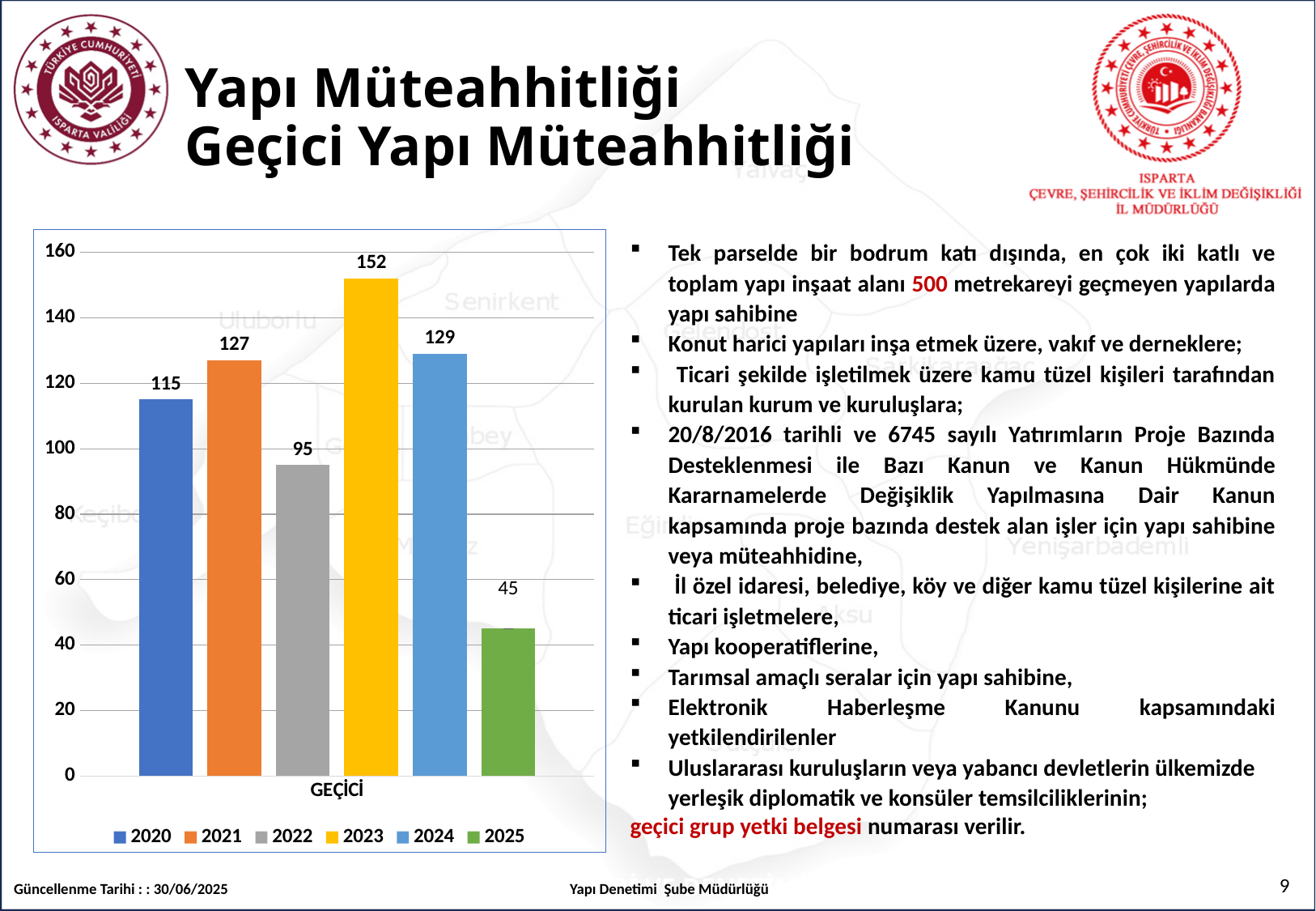
Which is larger, the value for 2021 or the value for 2024? 2024 Which year has the highest value in the chart? 2023 Is the value for 2022 greater or less than 100? less What colour is the bar for 2023 in the chart? yellow What is the value for 2025 in the chart? 45 What kind of chart is shown on the slide? bar chart What is the category label shown on the x axis of the chart? GEÇİCİ What is the difference between the values for 2023 and 2022? 57 What is the value for 2020 in the chart? 115 What is the value for 2023 in the chart? 152 How many series does the legend list? 6 Which year has the lowest value in the chart? 2025